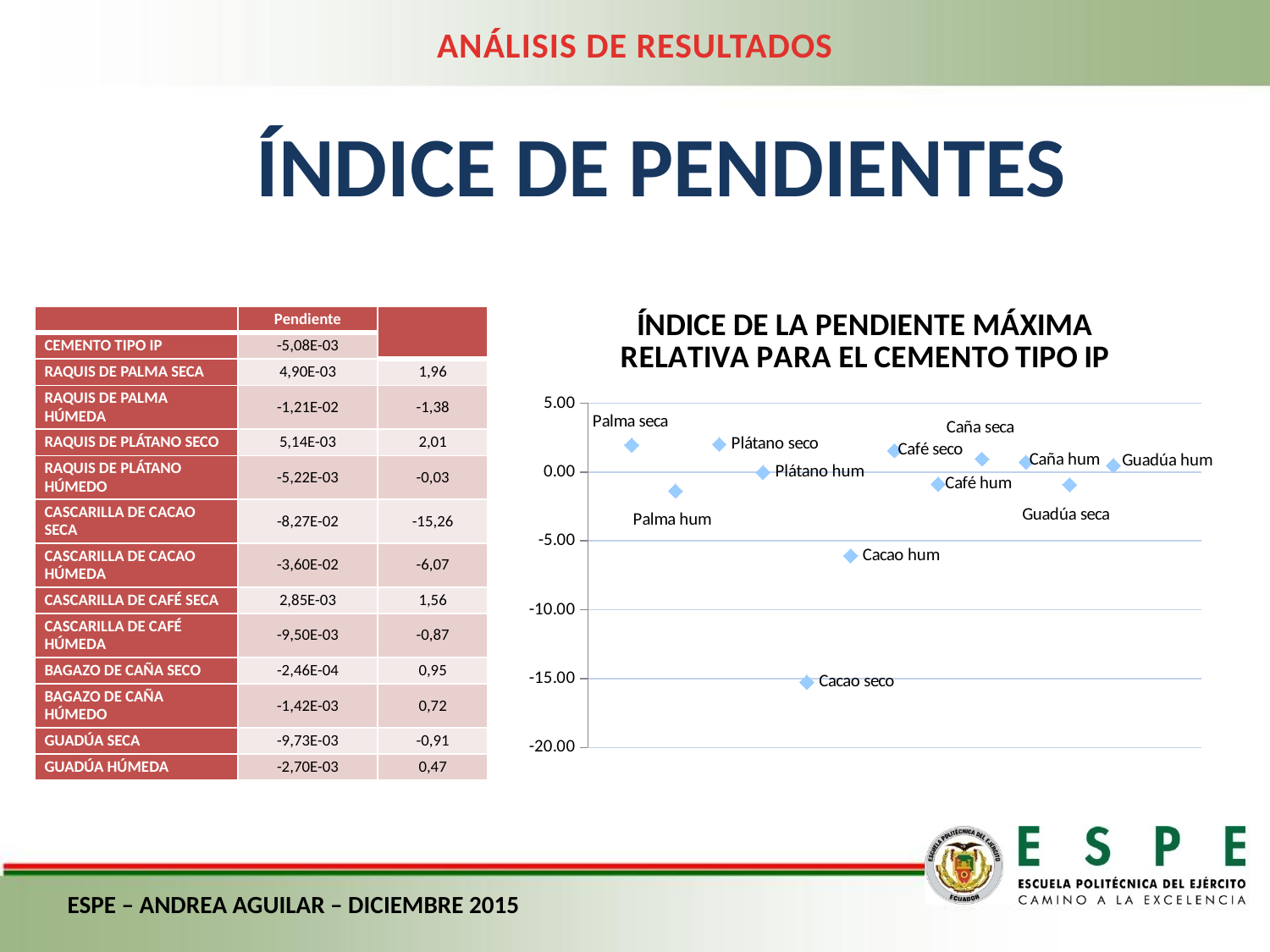
Which has the larger value, Guadúa hum or Guadúa seca? Guadúa hum What kind of chart is shown on the slide? scatter chart Is the value for Cacao seco greater or less than -10.00? less Is the value for Cacao hum greater or less than -5.00? less Is the value for Café hum greater or less than 0.00? less Which labeled point has the lowest value in the chart? Cacao seco Which has the larger value, Palma seca or Palma hum? Palma seca Which has the larger value, Cacao hum or Cacao seco? Cacao hum What is the title of the chart? ÍNDICE DE LA PENDIENTE MÁXIMA RELATIVA PARA EL CEMENTO TIPO IP What is the lowest value shown on the vertical axis of the chart? -20.00 How many labeled data points are plotted in the chart? 12